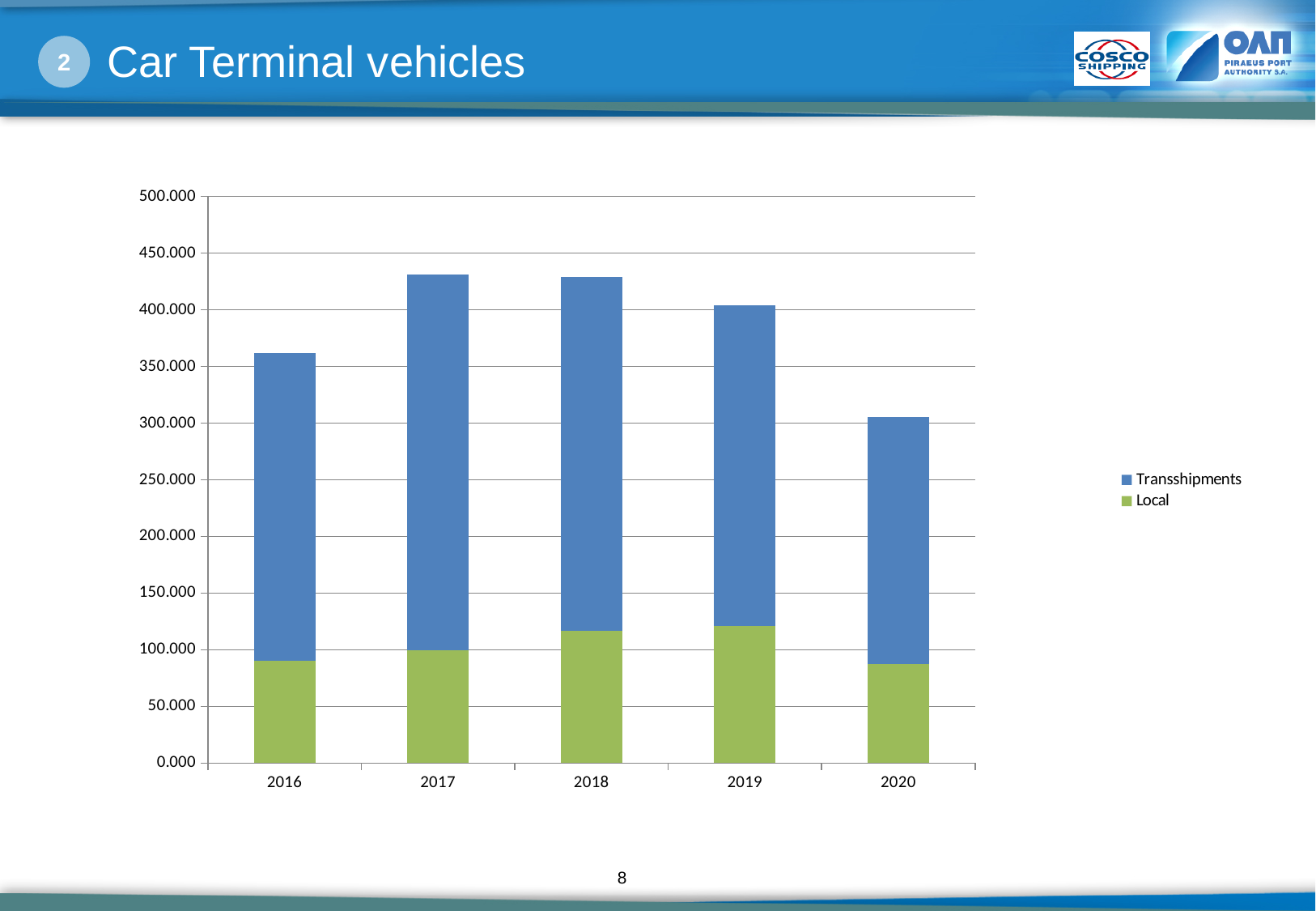
Is the Local value for 2018 greater or less than 100.000? greater Is the total bar for 2017 greater or less than 400.000? greater Which series is shown in green in the chart? Local What kind of chart is shown on the slide? Stacked bar chart How many years are shown on the x axis of the chart? 5 How many series does the chart's legend list? 2 Do the total bars rise or fall from 2017 to 2020? fall Is the Local value for 2016 greater or less than 100.000? less Which year has the lowest total bar in the chart? 2020 Which year has the larger Local value, 2017 or 2019? 2019 Which year has the larger total bar, 2016 or 2019? 2019